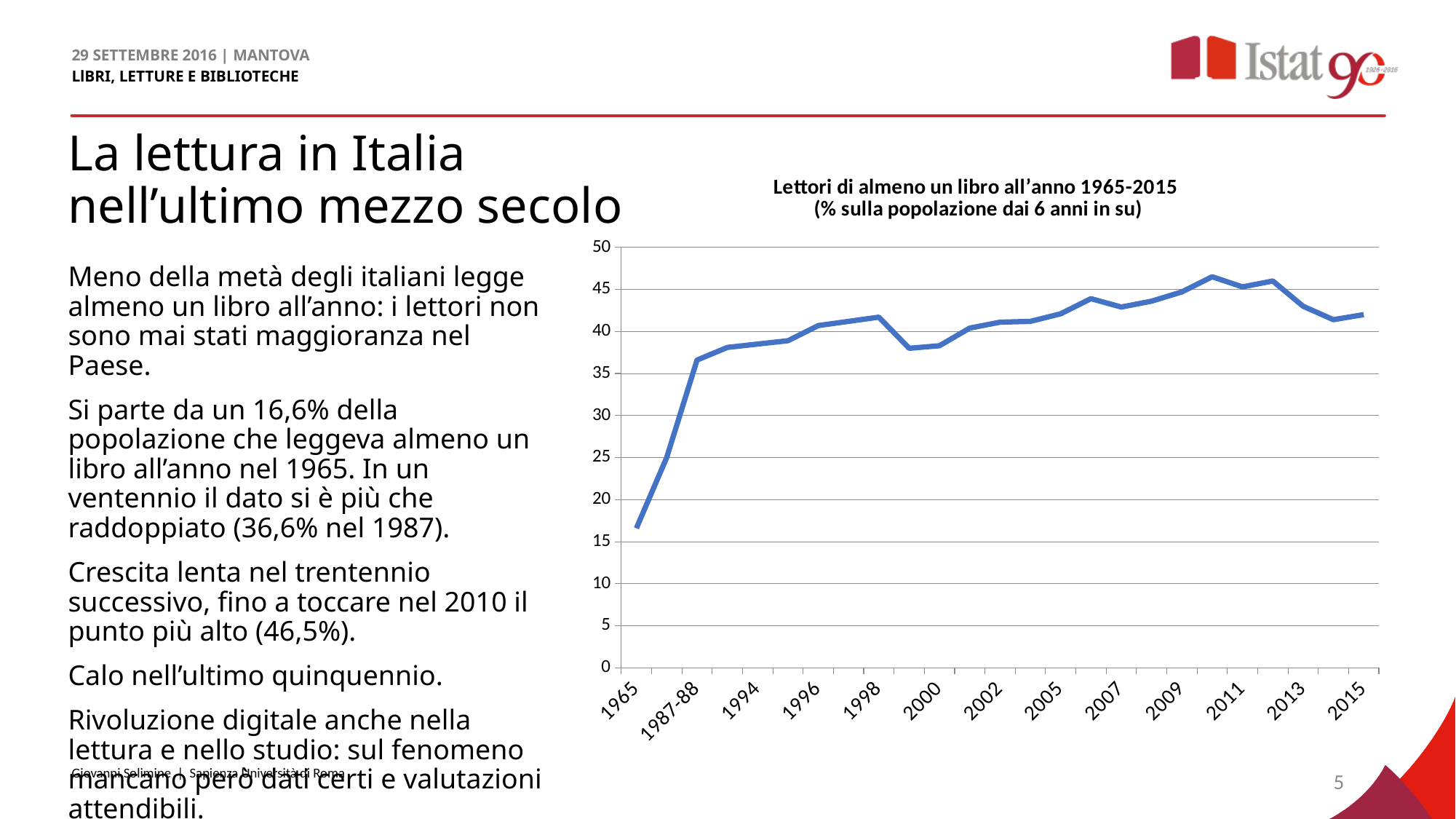
Do the values rise or fall from 1965 to 1998? rise Which is larger, the value for 1965 or the value for 2015? 2015 Is the value for 1998 greater or less than 40? greater Which year on the x axis has the lowest value? 1965 What kind of chart is shown on the slide? line chart Is the value for 1987-88 greater or less than 35? greater Is the value for 1965 greater or less than 20? less Which is larger, the value for 1998 or the value for 2000? 1998 What is the title of the chart? Lettori di almeno un libro all'anno 1965-2015 (% sulla popolazione dai 6 anni in su)